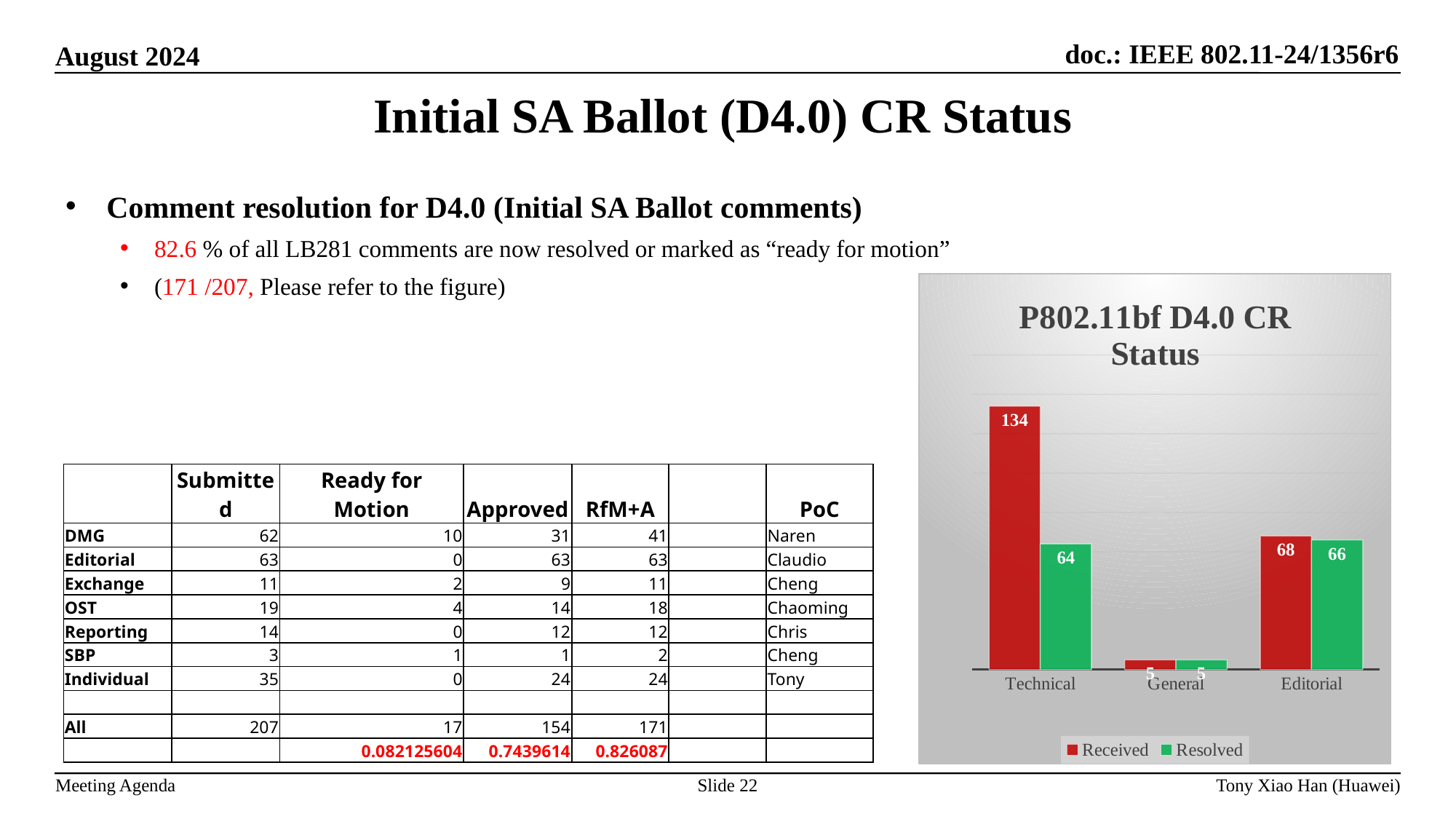
What is the Resolved value for Technical in the chart? 64 How many categories are shown on the x axis of the chart? 3 What type of chart is shown on the slide? Bar chart What is the Resolved value for Editorial in the chart? 66 What is the Received value for Technical in the P802.11bf D4.0 CR Status chart? 134 What is the Received value for Editorial in the chart? 68 What is the difference between Received and Resolved for Technical in the chart? 70 What is the difference between Received and Resolved for Editorial in the chart? 2 Which category has the lowest Resolved value in the chart? General Which category has the highest Received value in the chart? Technical How many series does the chart legend list? 2 Is the Received value for Technical larger than the Received value for Editorial in the chart? Yes